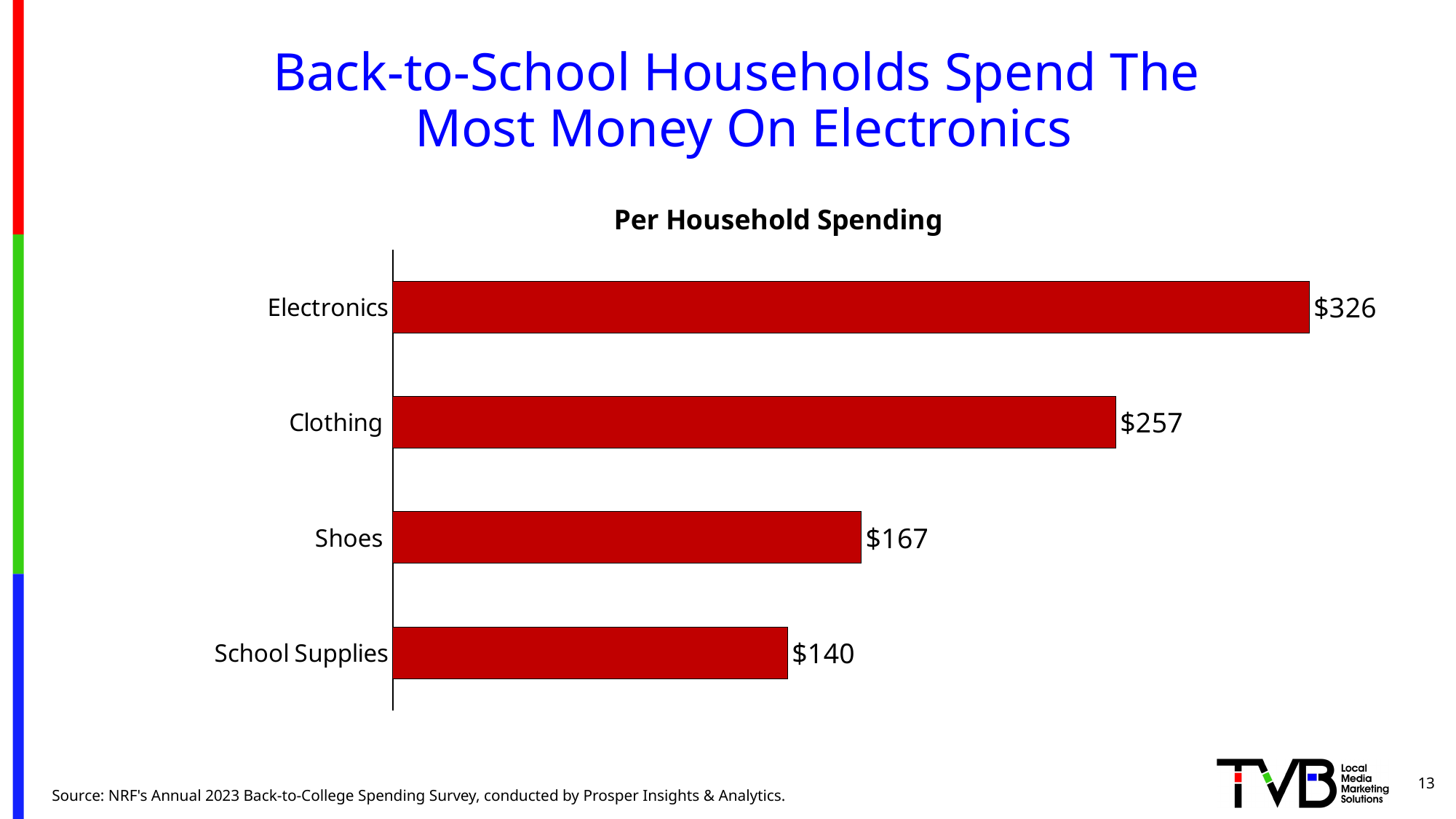
What type of chart is shown on the slide? Bar chart What is the per household spending on Shoes? $167 What is the difference in per household spending between Electronics and Clothing? $69 What is the title of the chart? Per Household Spending How many spending categories are shown in the chart? 4 Which category has the highest per household spending? Electronics Which has higher per household spending, Clothing or Shoes? Clothing What is the per household spending on Clothing? $257 What is the difference in per household spending between Shoes and School Supplies? $27 Which category has the lowest per household spending? School Supplies What is the per household spending on Electronics? $326 What is the per household spending on School Supplies? $140